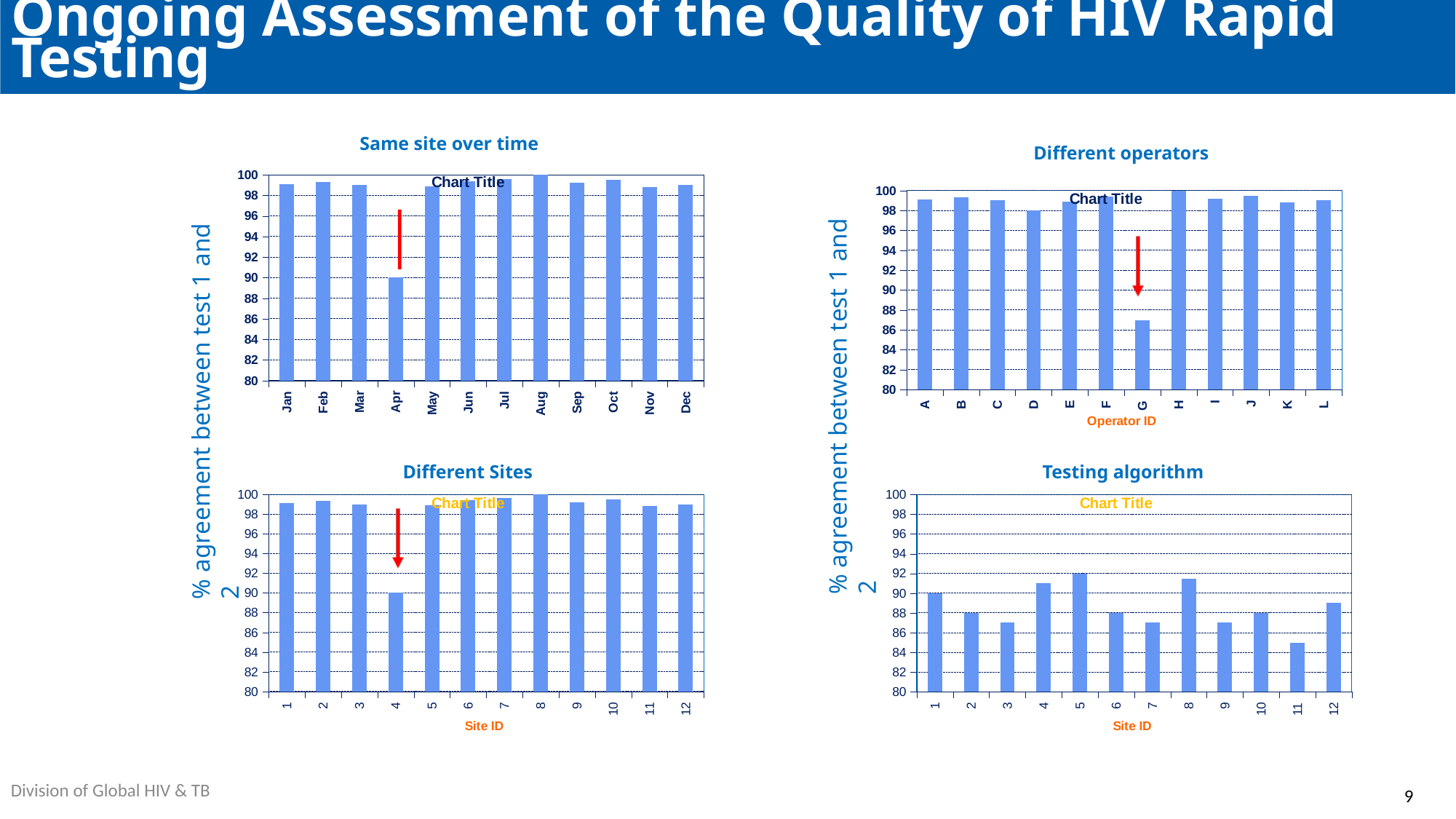
In the 'Different operators' chart, which operator has the lowest value? G In the 'Testing algorithm' chart, which site has the lowest value? 11 In the 'Different Sites' chart, what is the value for site 4? 90 In the 'Testing algorithm' chart, which has the larger value, site 1 or site 11? site 1 In the 'Different operators' chart, is the value for operator G greater or less than 88? less In the 'Same site over time' chart, what is the difference between the values for Aug and Apr? 10 In the 'Same site over time' chart, which month has the lowest value? Apr In the 'Same site over time' chart, what is the value for Apr? 90 In the 'Testing algorithm' chart, what is the value for site 5? 92 How many sites are shown on the x axis of the 'Testing algorithm' chart? 12 In the 'Testing algorithm' chart, is the value for site 11 greater or less than 86? less